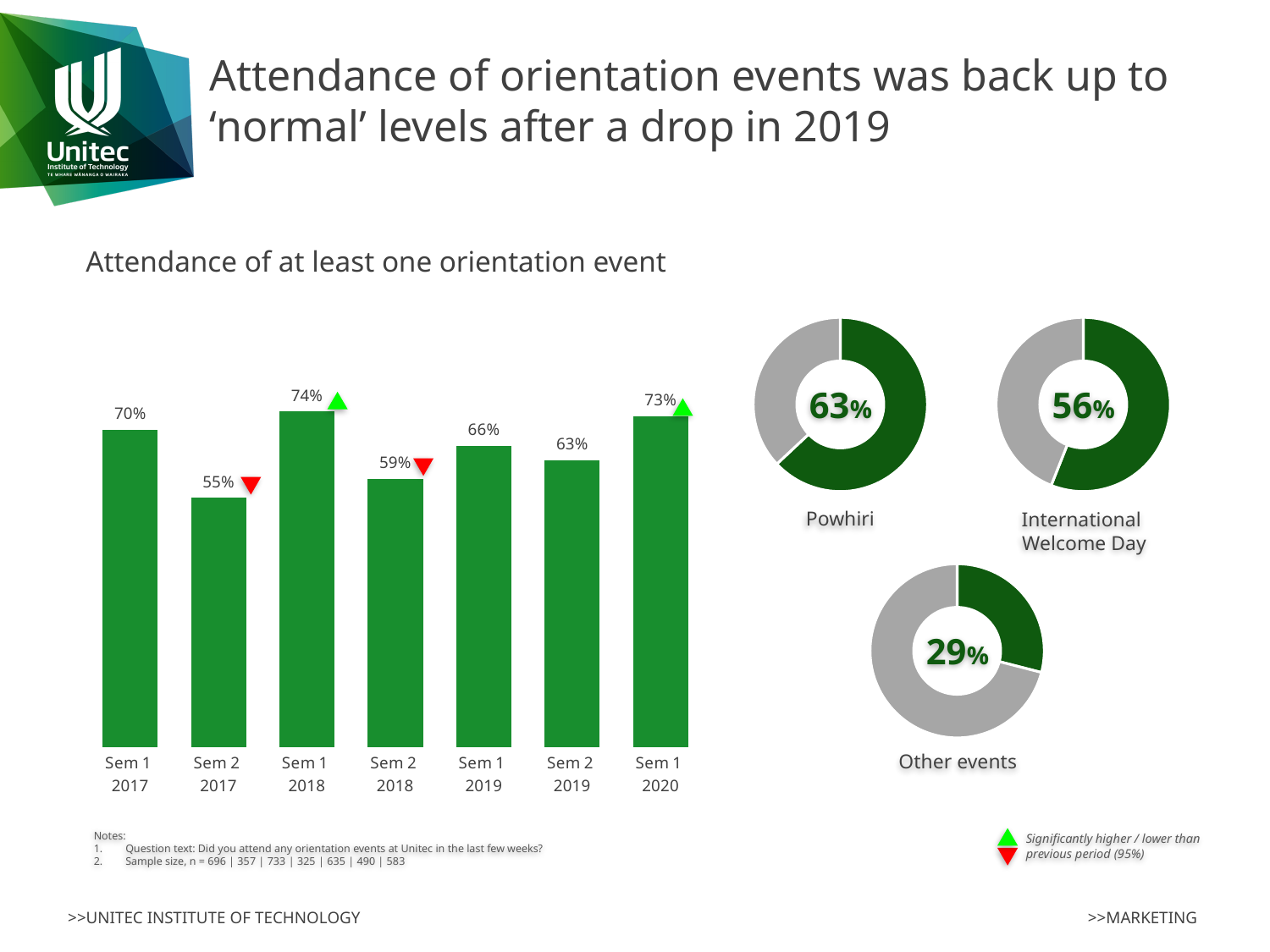
In the bar chart 'Attendance of at least one orientation event', what is the value for Sem 1 2020? 73% Among the three donut charts on the right of the slide, which event has the lowest attendance share? Other events In the donut chart for Powhiri on the right of the slide, what share attended? 63% In the bar chart 'Attendance of at least one orientation event', which is larger, Sem 1 2019 or Sem 2 2019? Sem 1 2019 What kind of chart is 'Attendance of at least one orientation event'? Bar chart In the bar chart 'Attendance of at least one orientation event', what is the difference between Sem 1 2018 and Sem 2 2018? 15% In the bar chart 'Attendance of at least one orientation event', which semester has the lowest attendance? Sem 2 2017 In the bar chart 'Attendance of at least one orientation event', what is the value for Sem 2 2017? 55% In the bar chart 'Attendance of at least one orientation event', which semester has the highest attendance? Sem 1 2018 In the donut chart for Other events on the right of the slide, what share attended? 29% In the bar chart 'Attendance of at least one orientation event', did attendance rise or fall from Sem 2 2019 to Sem 1 2020? Rise How many semesters are shown in the bar chart 'Attendance of at least one orientation event'? 7